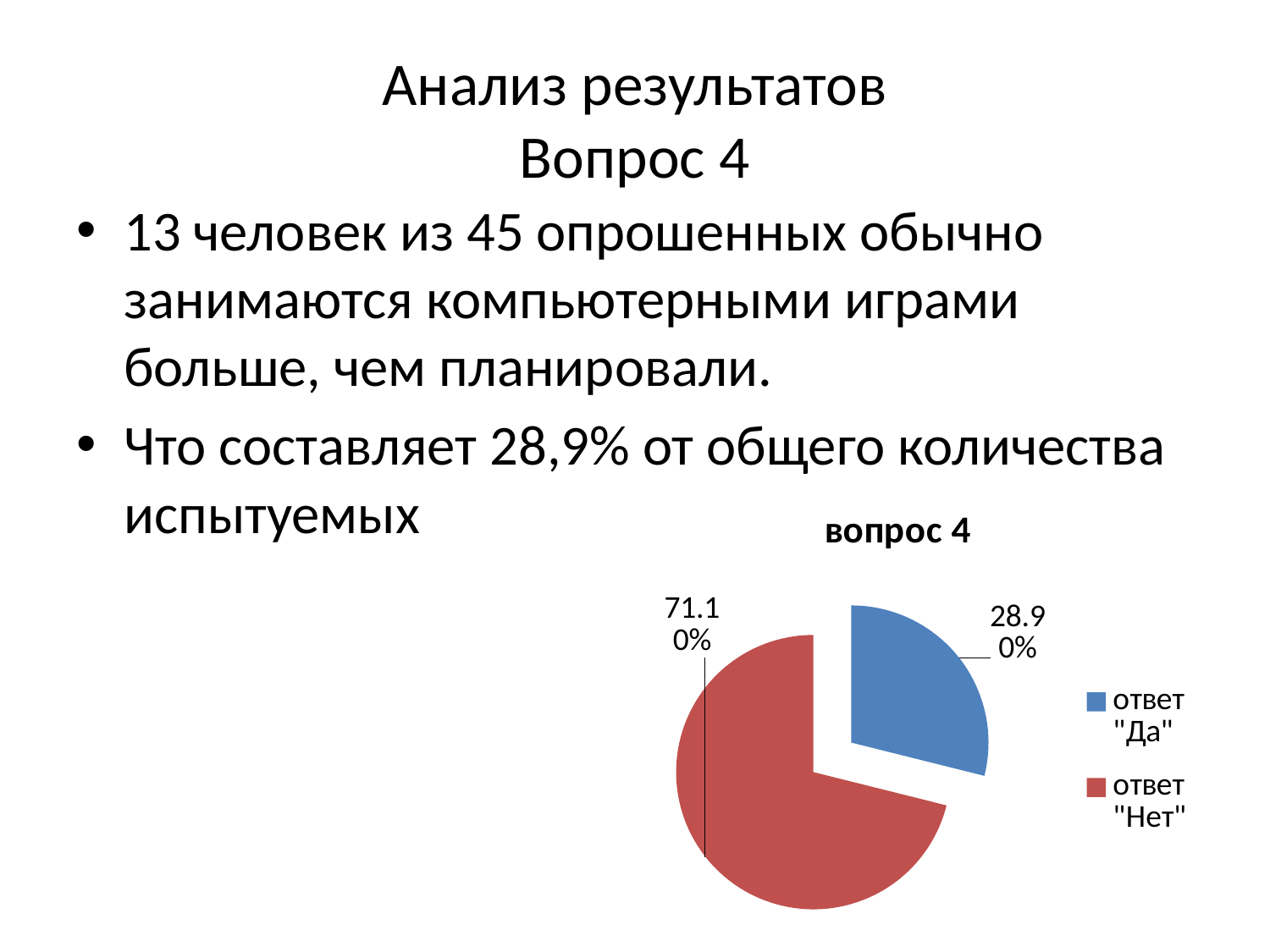
What is the title of the chart on the slide? вопрос 4 What colour is the ответ "Нет" slice in the pie chart? Red What is the value shown for the slice ответ "Нет" in the pie chart? 71.10% Which is larger in the pie chart: ответ "Да" or ответ "Нет"? ответ "Нет" What kind of chart is shown on the slide? Pie chart Which slice of the pie chart is the smallest? ответ "Да" How many slices does the pie chart have? 2 Which slice of the pie chart is the largest? ответ "Нет" What is the value shown for the slice ответ "Да" in the pie chart? 28.90% How many entries does the legend of the pie chart list? 2 What share of the pie does the ответ "Да" slice represent? 28.90% What is the difference between the ответ "Нет" and ответ "Да" values in the pie chart? 42.20%